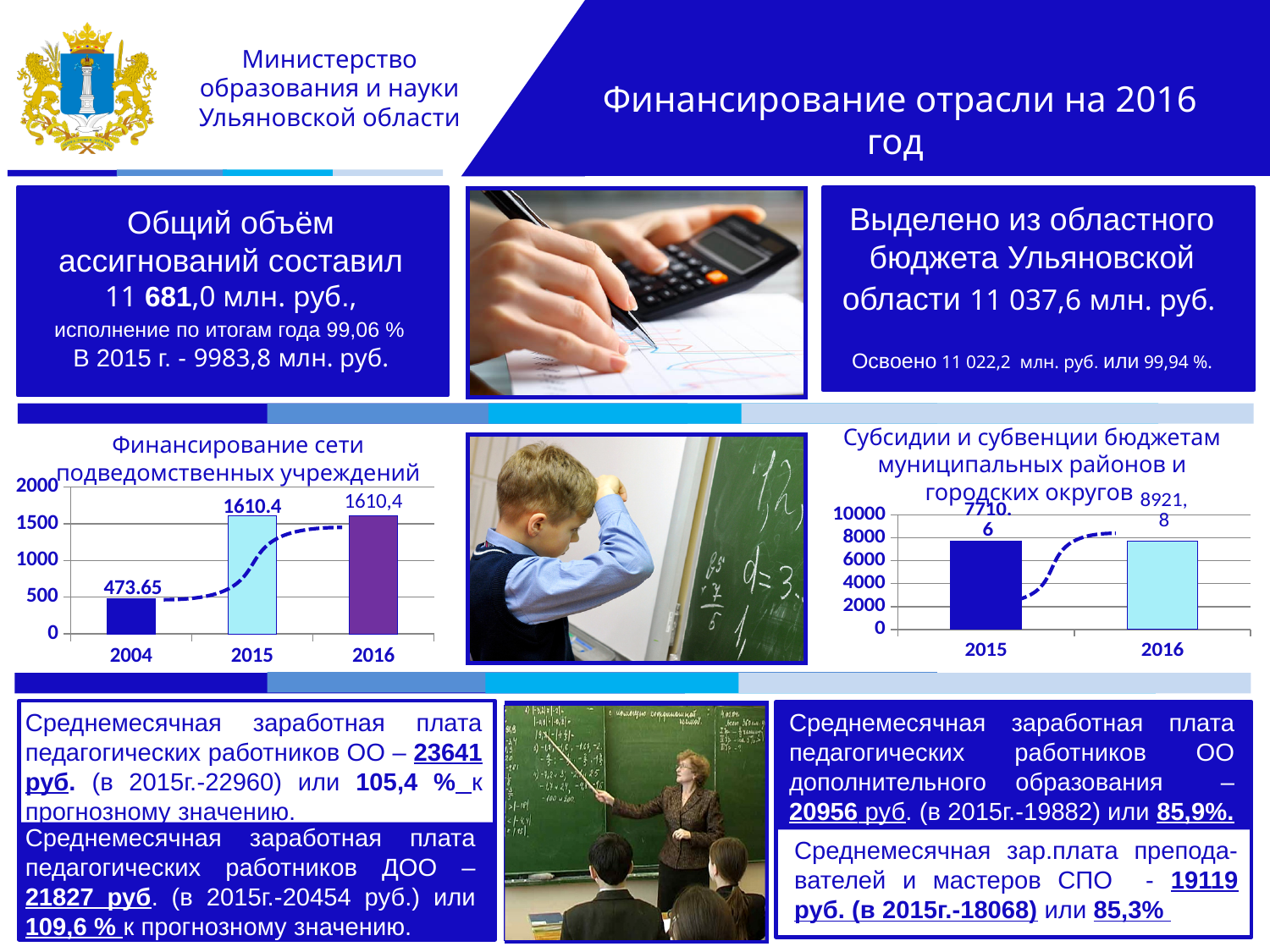
In the chart 'Финансирование сети подведомственных учреждений', is the value for 2004 greater or less than 500? less In the chart 'Финансирование сети подведомственных учреждений', do the values rise or fall from 2004 to 2015? rise In the chart 'Финансирование сети подведомственных учреждений', what is the difference between the values for 2015 and 2004? 1136.75 In the chart 'Финансирование сети подведомственных учреждений', what is the value for 2004? 473.65 In the chart 'Финансирование сети подведомственных учреждений', what is the value for 2015? 1610.4 In the chart 'Финансирование сети подведомственных учреждений', which is larger, the value for 2004 or the value for 2015? 2015 How many years are shown on the x axis of the chart 'Субсидии и субвенции бюджетам муниципальных районов и городских округов'? 2 In the chart 'Субсидии и субвенции бюджетам муниципальных районов и городских округов', what is the value labelled for 2015? 7710.6 How many years are shown on the x axis of the chart 'Финансирование сети подведомственных учреждений'? 3 In the chart 'Финансирование сети подведомственных учреждений', which year has the lowest value? 2004 In the chart 'Субсидии и субвенции бюджетам муниципальных районов и городских округов', is the value for 2015 greater or less than 6000? greater What kind of chart is 'Финансирование сети подведомственных учреждений'? bar chart